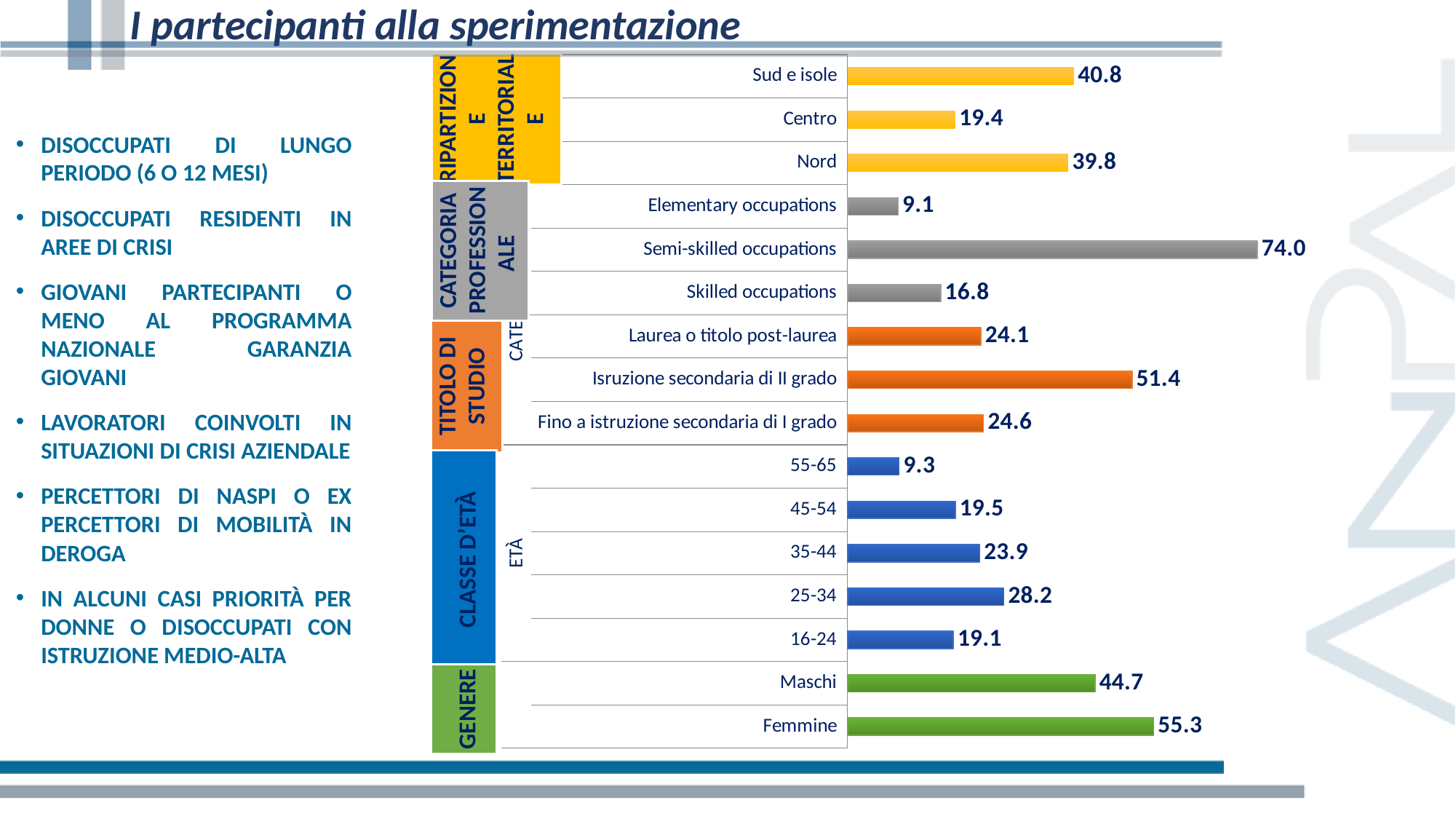
Which is larger, the value for Laurea o titolo post-laurea or for Isruzione secondaria di II grado? Isruzione secondaria di II grado Which age class has the lowest value? 55-65 How many bars are plotted in the chart? 16 What is the difference between the values for Sud e isole and Centro? 21.4 What is the value for Semi-skilled occupations? 74.0 What is the value for Sud e isole? 40.8 What is the difference between the values for Femmine and Maschi? 10.6 What kind of chart is shown on the slide? Bar chart What is the value for Femmine? 55.3 What is the value for the 25-34 age class? 28.2 Which category has the lowest value in the chart? Elementary occupations Which category has the highest value in the chart? Semi-skilled occupations